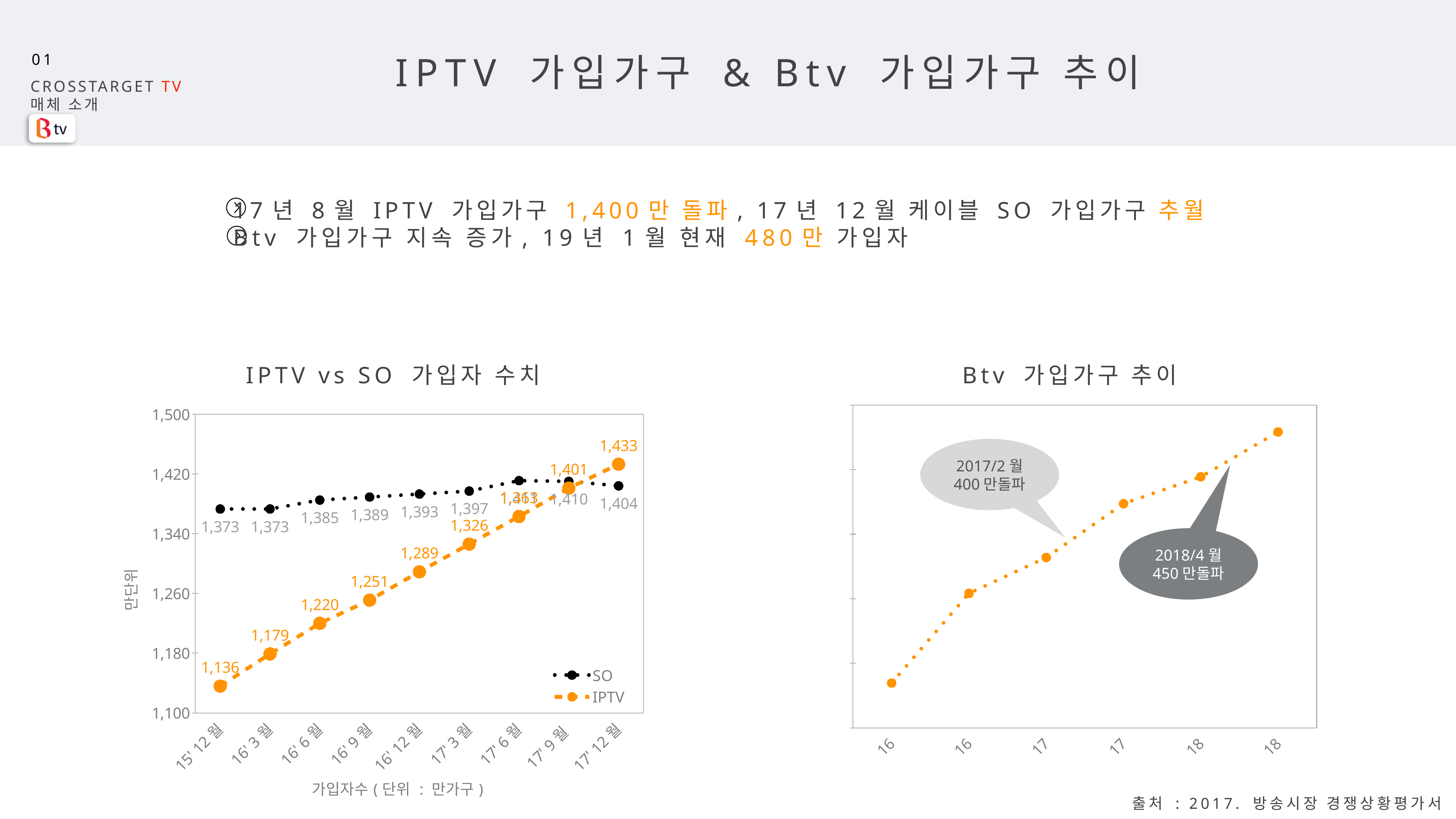
In the 'IPTV vs SO 가입자 수치' chart, what is the difference between the SO values at 17'9월 and 17'12월? 6 In the 'IPTV vs SO 가입자 수치' chart, what is the SO value at 15'12월? 1,373 In the 'IPTV vs SO 가입자 수치' chart, at which period is the IPTV value lowest? 15'12월 In the 'IPTV vs SO 가입자 수치' chart, by how much did the IPTV value increase from 15'12월 to 17'12월? 297 In the 'IPTV vs SO 가입자 수치' chart, which series has the larger value at 16'12월, SO or IPTV? SO In the 'IPTV vs SO 가입자 수치' chart, what is the IPTV value at 17'12월? 1,433 In the 'IPTV vs SO 가입자 수치' chart, which series has the larger value at 17'12월, SO or IPTV? IPTV How many time periods are shown on the x axis of the 'IPTV vs SO 가입자 수치' chart? 9 In the 'IPTV vs SO 가입자 수치' chart, what is the IPTV value at 16'6월? 1,220 In the 'IPTV vs SO 가입자 수치' chart, at which period is the IPTV value highest? 17'12월 In the 'Btv 가입가구 추이' chart, do the values rise or fall from left to right? rise How many series does the legend of the 'IPTV vs SO 가입자 수치' chart list? 2